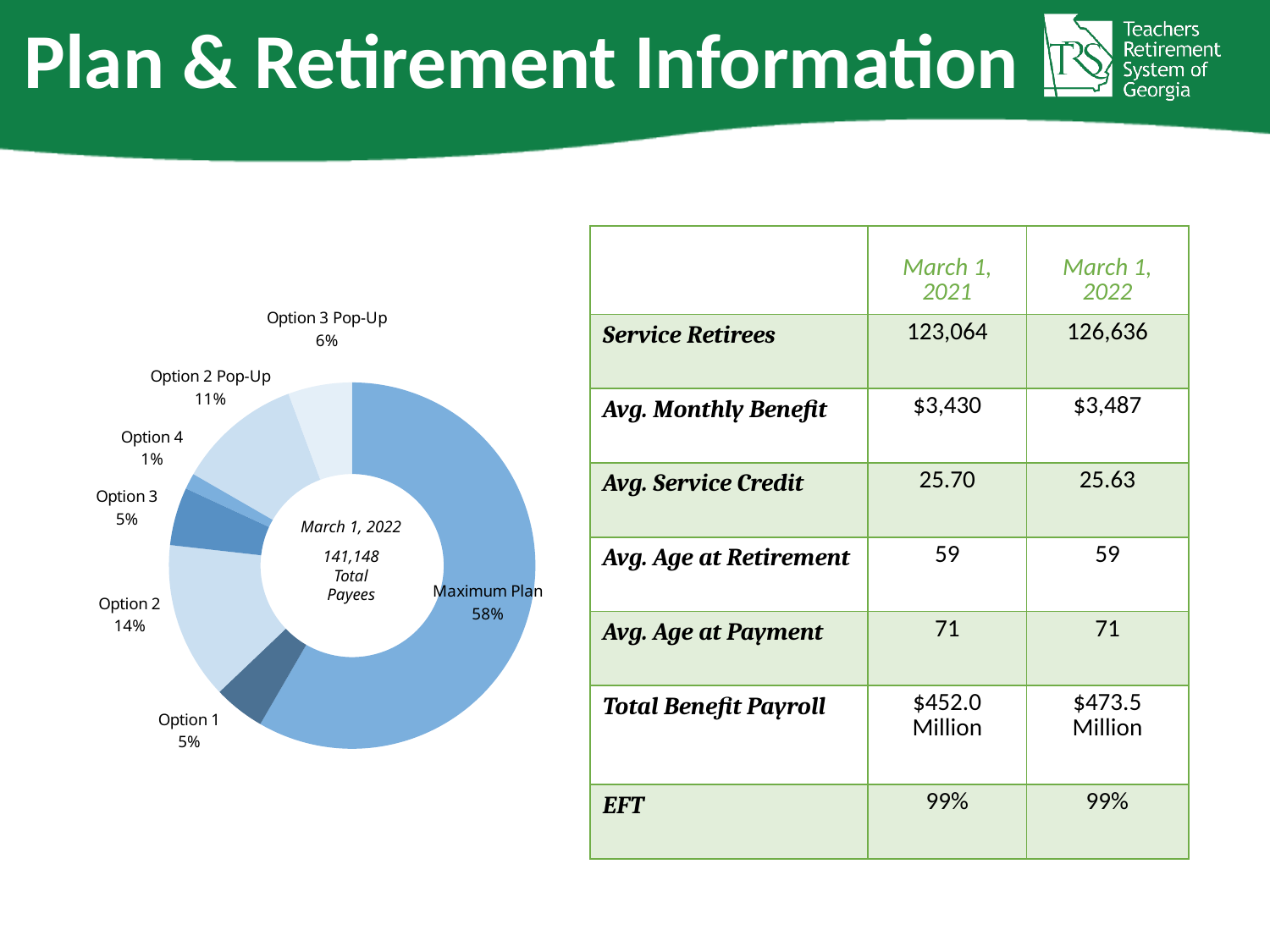
What is the value shown for Option 2 in the pie chart? 14% Which category has the largest slice in the pie chart? Maximum Plan What is the difference in percentage points between Option 2 and Option 2 Pop-Up in the pie chart? 3 How many categories are shown in the pie chart? 7 Which category has the smallest slice in the pie chart? Option 4 What is the value shown for Option 2 Pop-Up in the pie chart? 11% Which is larger in the pie chart, Option 2 or Option 3 Pop-Up? Option 2 What date is shown in the center of the pie chart? March 1, 2022 What total number of payees is shown in the center of the pie chart? 141,148 What kind of chart is shown on the slide? doughnut chart What share of the pie chart does Maximum Plan represent? 58% What is the value shown for Option 3 Pop-Up in the pie chart? 6%